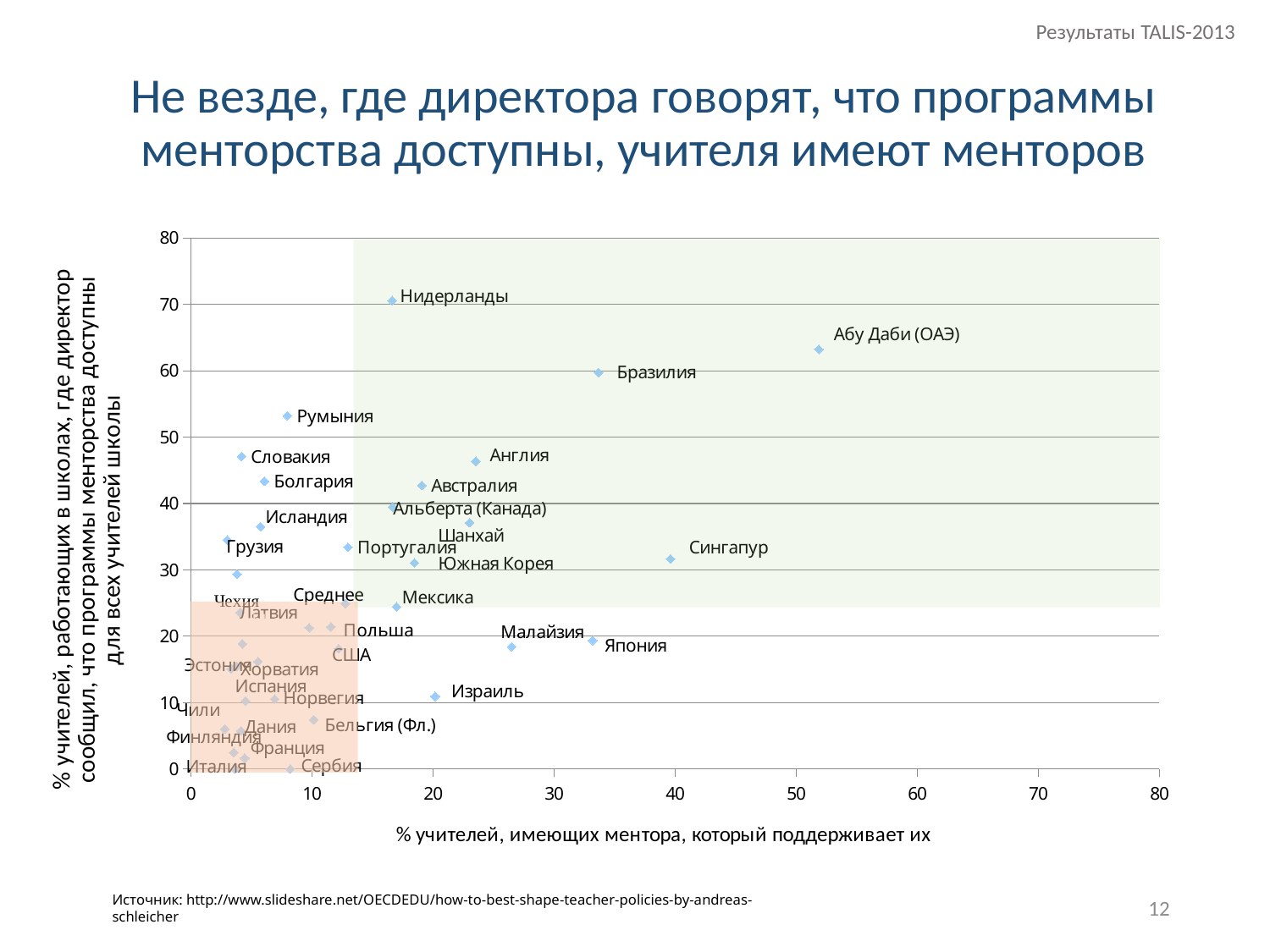
Is the horizontal-axis value for Бразилия greater or less than 30? greater Which country has the highest value on the horizontal axis (% of teachers who have a mentor)? Абу Даби (ОАЭ) Is the vertical-axis value for Израиль greater or less than 20? less Which has the larger horizontal-axis value, Сингапур or Бразилия? Сингапур Is the horizontal-axis value for Абу Даби (ОАЭ) greater or less than 50? greater What is the title of the horizontal axis? % учителей, имеющих ментора, который поддерживает их What kind of chart is shown on the slide? scatter chart Which country has the highest value on the vertical axis (% of teachers working in schools where the principal reports mentoring programmes are available)? Нидерланды Which has the larger vertical-axis value, Нидерланды or Абу Даби (ОАЭ)? Нидерланды